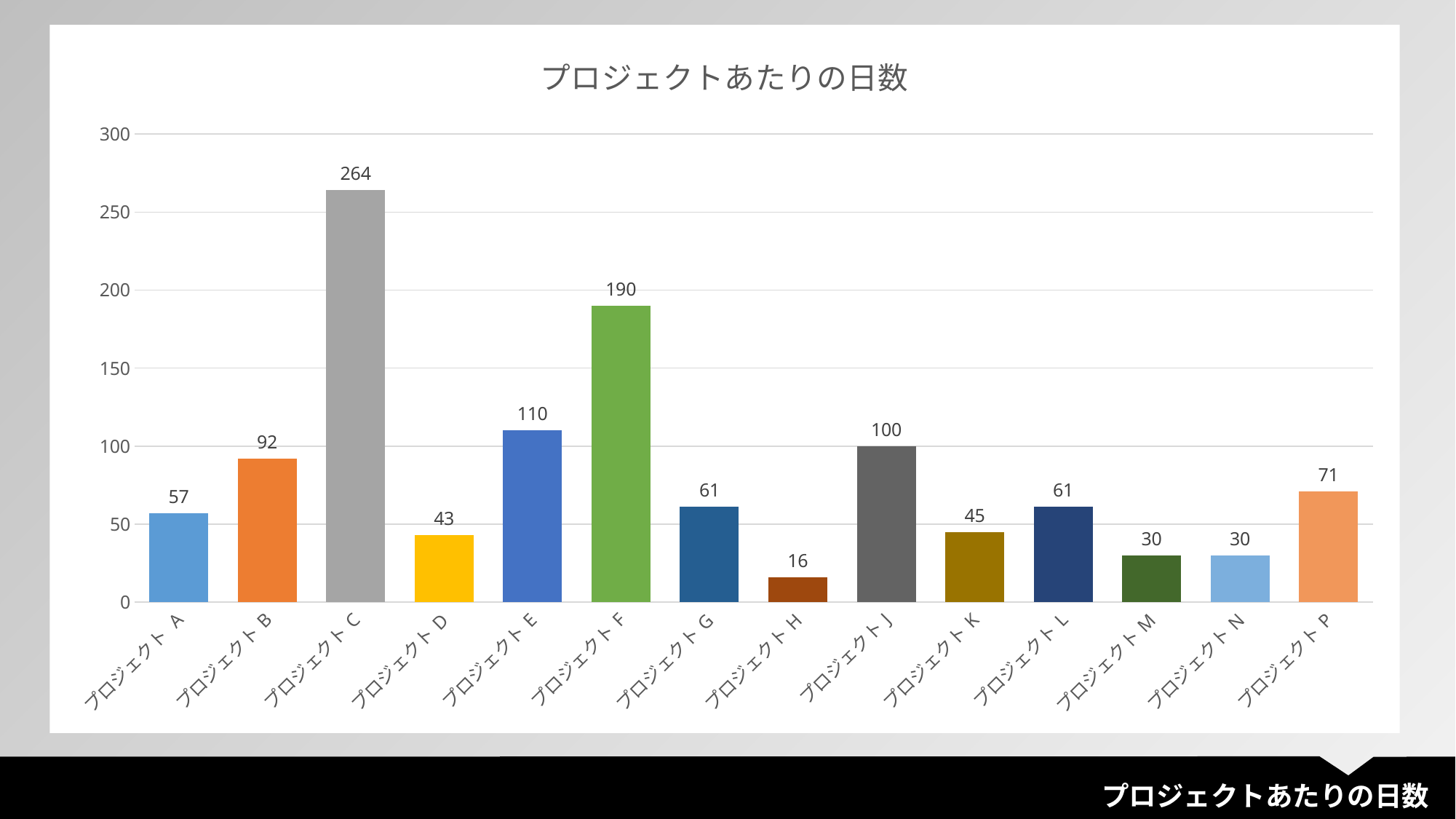
Which is larger, the value for プロジェクト B or the value for プロジェクト K? プロジェクト B What is the difference between the values for プロジェクト C and プロジェクト F? 74 How many projects are shown on the chart? 14 What is the value for プロジェクト H? 16 What is the value for プロジェクト C? 264 Is the value for プロジェクト F greater or less than 150? greater What is the value for プロジェクト P? 71 What is the title of the chart? プロジェクトあたりの日数 Which project has the highest number of days? プロジェクト C What kind of chart is shown on the slide? bar chart What is the difference between the values for プロジェクト E and プロジェクト J? 10 Which project has the lowest number of days? プロジェクト H